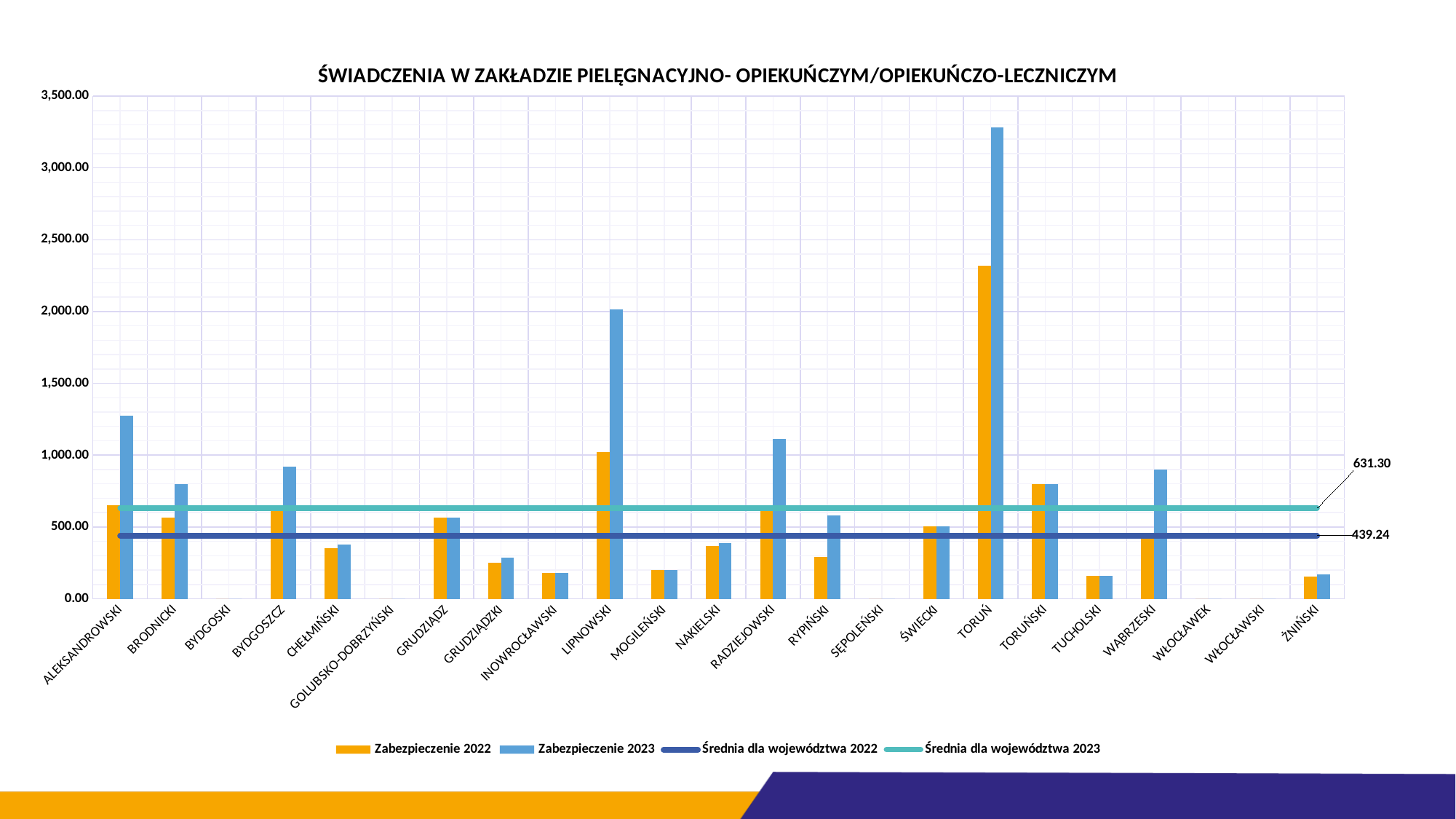
What is the value of the line 'Średnia dla województwa 2022'? 439.24 Which is larger for ALEKSANDROWSKI: 'Zabezpieczenie 2022' or 'Zabezpieczenie 2023'? Zabezpieczenie 2023 Which category has the highest value for 'Zabezpieczenie 2022'? TORUŃ Is the value for LIPNOWSKI in 'Zabezpieczenie 2023' greater or less than 1,500.00? greater What kind of chart is shown on the slide? combination bar and line chart How many series does the legend list? 4 What is the value of the line 'Średnia dla województwa 2023'? 631.30 How many categories are shown on the x axis? 23 What is the title of the chart? ŚWIADCZENIA W ZAKŁADZIE PIELĘGNACYJNO- OPIEKUŃCZYM/OPIEKUŃCZO-LECZNICZYM Is the value for TORUŃ in 'Zabezpieczenie 2023' greater or less than 3,000.00? greater Which category has the highest value for 'Zabezpieczenie 2023'? TORUŃ What is the difference between 'Średnia dla województwa 2023' and 'Średnia dla województwa 2022'? 192.06